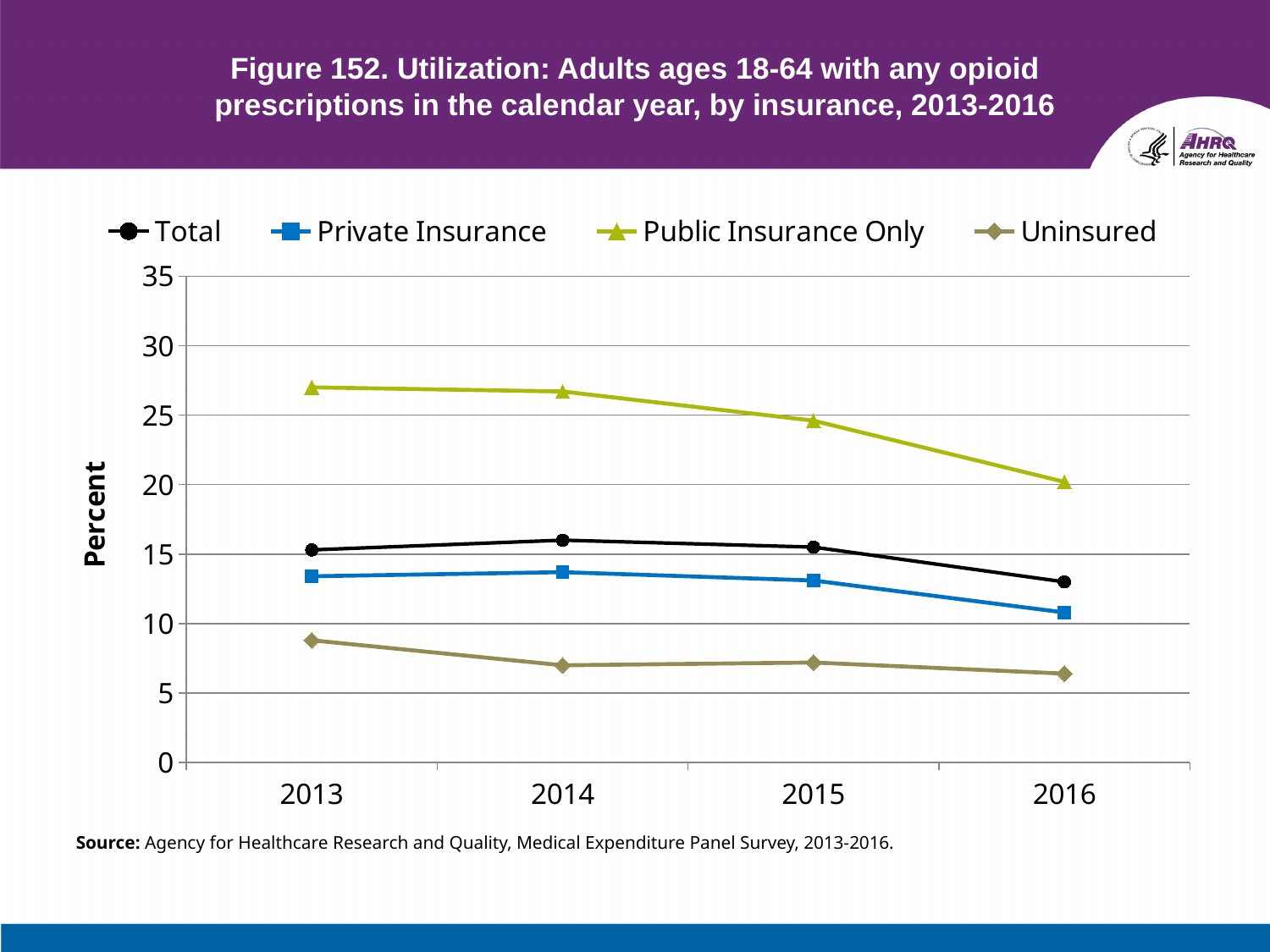
Does the Public Insurance Only series rise or fall from 2013 to 2016? fall Is the value for Public Insurance Only in 2013 greater or less than 25? greater Is the value for Uninsured in 2016 greater or less than 5? greater Is the value for Uninsured in 2013 greater or less than 10? less What is the label on the y axis? Percent In 2016, which is larger: Public Insurance Only or Total? Public Insurance Only How many series does the legend list? 4 Which series has the highest value in 2013? Public Insurance Only Which series has the lowest value in 2016? Uninsured What kind of chart is shown on the slide? line chart How many years are plotted along the x axis? 4